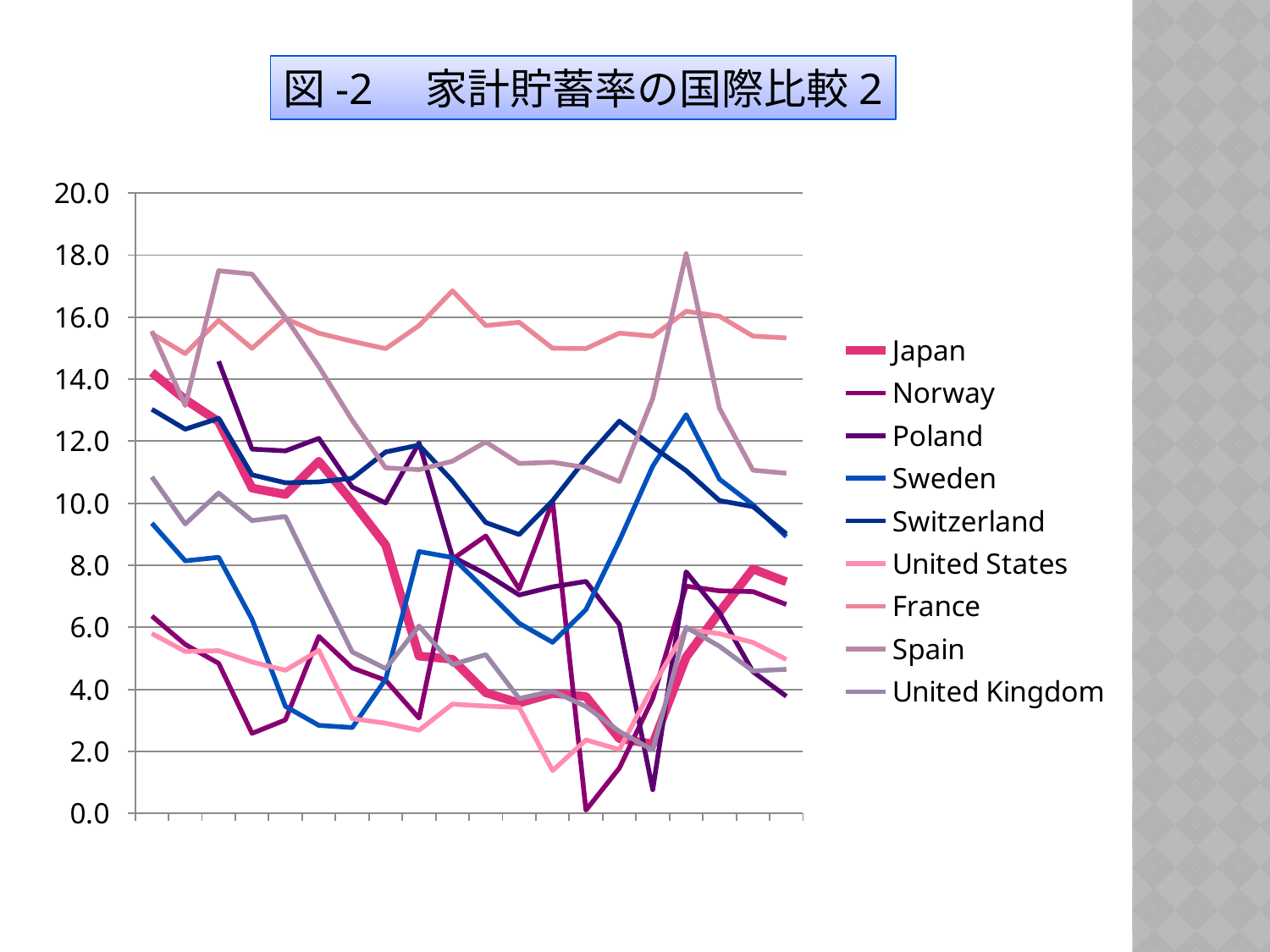
What is the title of the chart on the slide? 図-2 家計貯蓄率の国際比較2 Which series is drawn with the thick pink line? Japan Is the peak value of the Spain line greater or less than 16.0? greater Is the lowest value of the France line greater or less than 14.0? greater At the leftmost point, which is higher, Japan or Sweden? Japan How many series does the legend list? 9 Which series reaches the highest value anywhere on the chart? Spain Which series reaches the lowest value anywhere on the chart? Norway Is the lowest value of the Poland line greater or less than 2.0? less Does the Japan line overall rise or fall from left to right? fall What kind of chart is shown on the slide? line chart